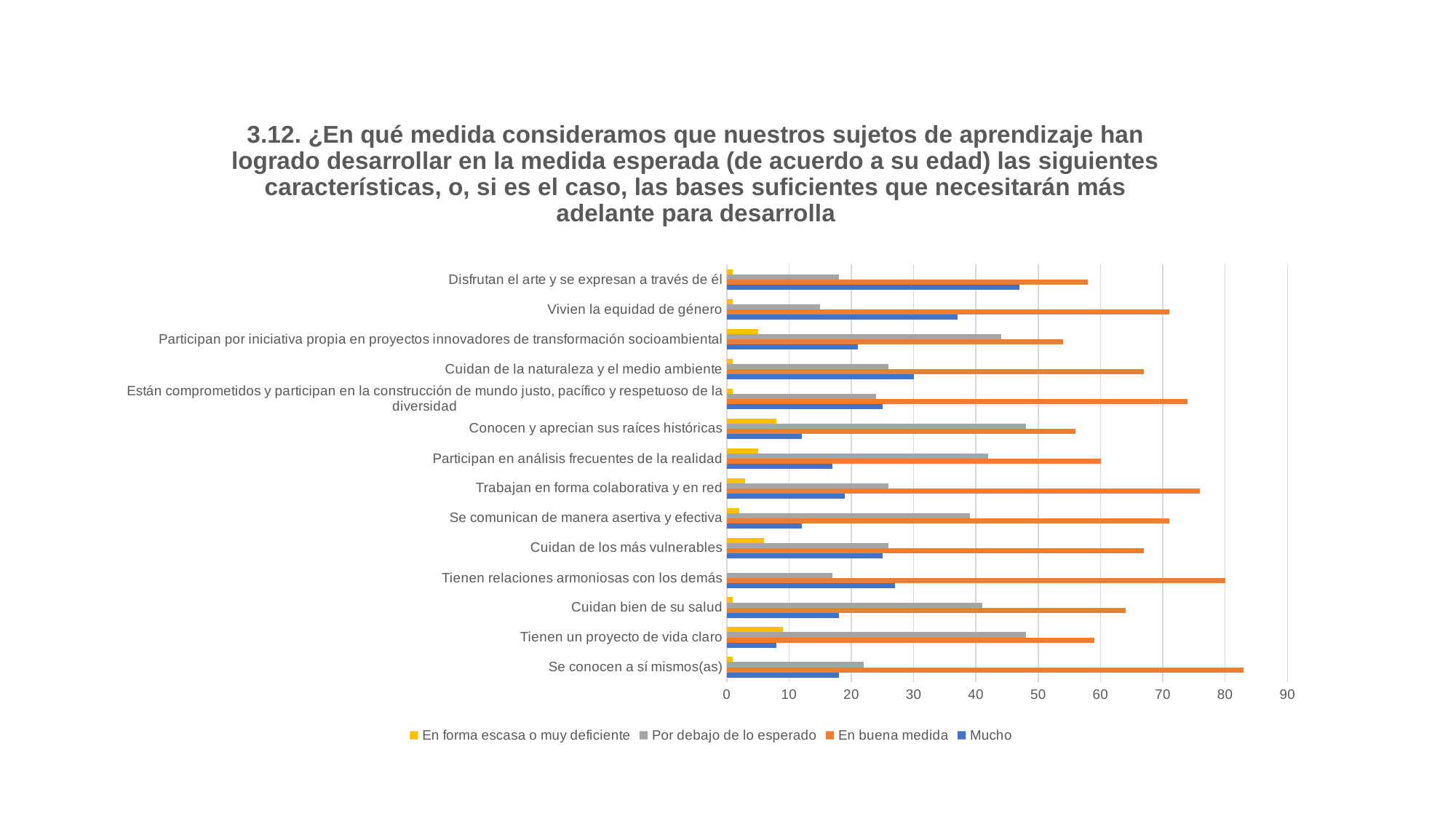
What kind of chart is shown on the slide? bar chart Is the 'Por debajo de lo esperado' value for 'Conocen y aprecian sus raíces históricas' greater or less than 40? greater Which colour represents the 'Mucho' series in the legend? blue How many categories are plotted on the chart? 14 For the 'Por debajo de lo esperado' series, which is larger: 'Participan por iniciativa propia en proyectos innovadores de transformación socioambiental' or 'Cuidan de los más vulnerables'? Participan por iniciativa propia en proyectos innovadores de transformación socioambiental Is the 'Mucho' value for 'Disfrutan el arte y se expresan a través de él' greater or less than 40? greater For the 'Mucho' series, which is larger: 'Disfrutan el arte y se expresan a través de él' or 'Cuidan de la naturaleza y el medio ambiente'? Disfrutan el arte y se expresan a través de él How many series does the legend list? 4 Is the 'Por debajo de lo esperado' value for 'Vivien la equidad de género' greater or less than 20? less Which category has the highest value for the 'Mucho' series? Disfrutan el arte y se expresan a través de él Which category has the lowest value for the 'Mucho' series? Tienen un proyecto de vida claro